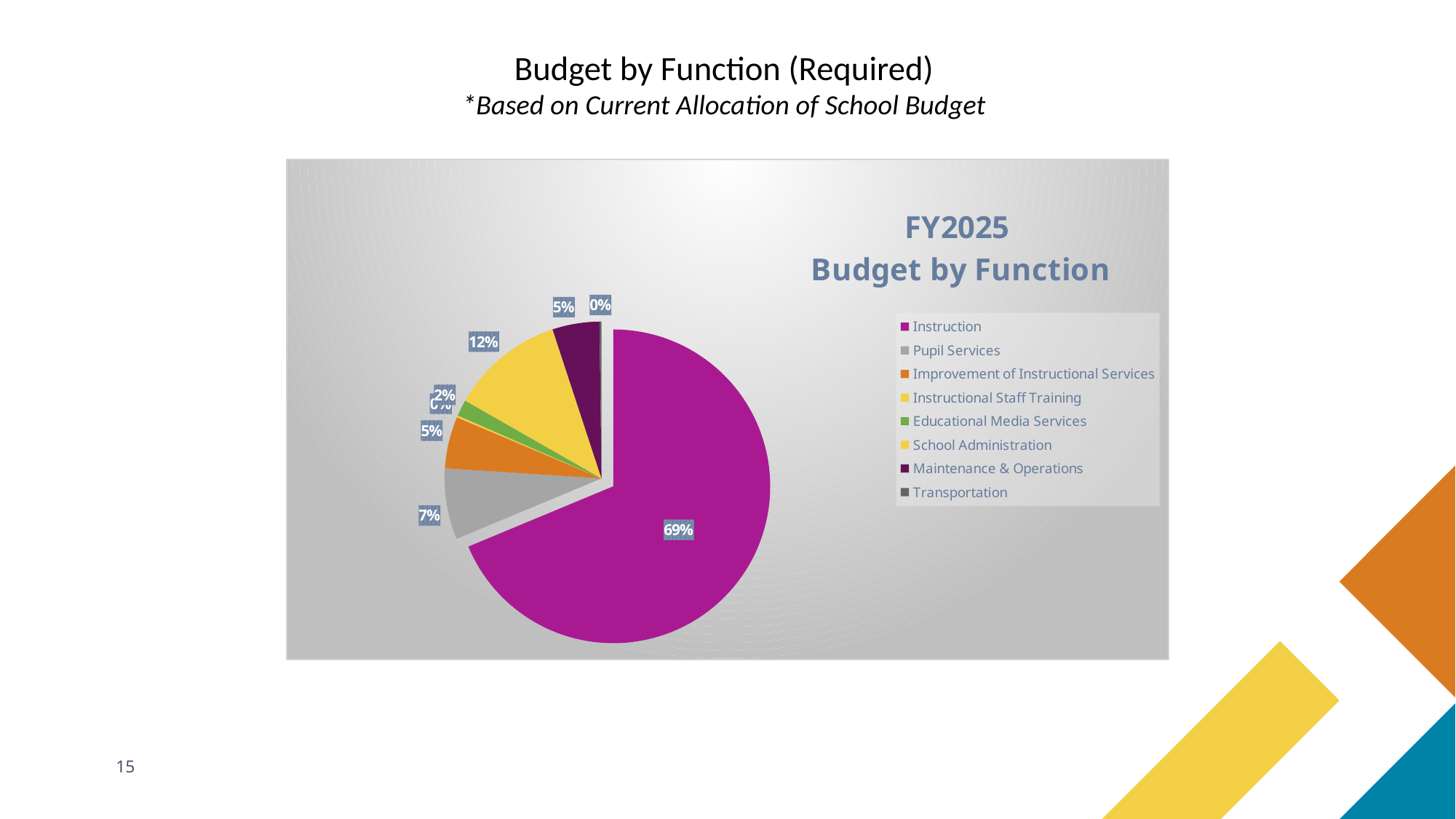
What is the difference in percentage points between Instruction and School Administration? 57 percentage points Which is larger, the share for Pupil Services or the share for Maintenance & Operations? Pupil Services What is the title of the chart? FY2025 Budget by Function What share of the FY2025 budget goes to Instruction? 69% What percentage is shown for Maintenance & Operations? 5% What percentage is shown for School Administration? 12% What percentage is shown for Transportation? 0% Which function has the largest share of the budget? Instruction What kind of chart is shown on the slide? Pie chart How many categories does the legend list? 8 What colour is the Instruction slice? Magenta What percentage is shown for Pupil Services? 7%